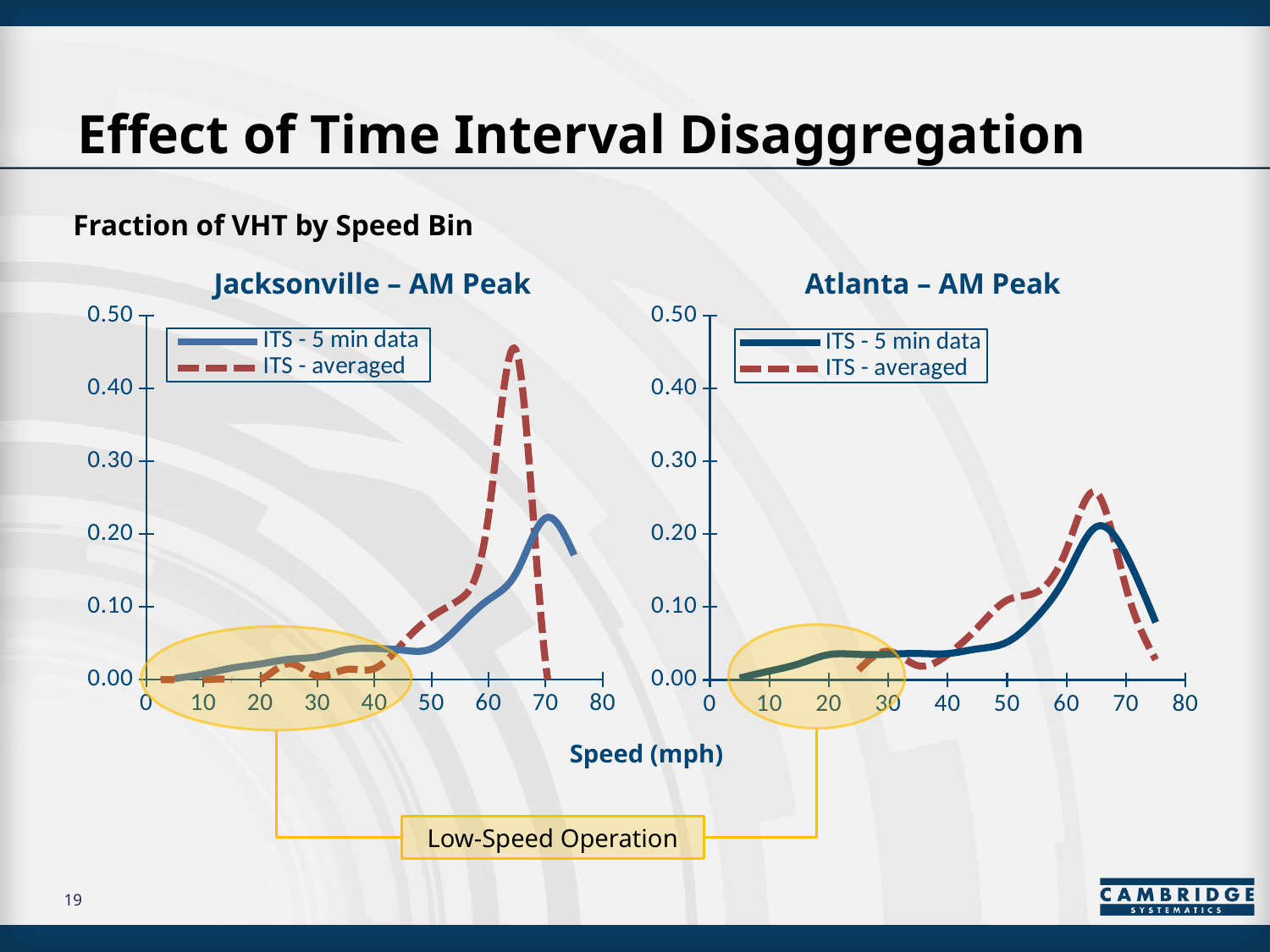
How many series does the legend of the Atlanta – AM Peak chart list? 2 In the Jacksonville – AM Peak chart, which series reaches the higher peak value, ITS - 5 min data or ITS - averaged? ITS - averaged In the Atlanta – AM Peak chart, does the ITS - 5 min data series rise or fall between 50 mph and 65 mph? rise In the Jacksonville – AM Peak chart, is the peak value of the ITS - averaged series greater or less than 0.40? greater What is the label of the shared x axis below the two charts? Speed (mph) In the Atlanta – AM Peak chart, is the peak value of the ITS - averaged series greater or less than 0.20? greater In the Atlanta – AM Peak chart, is the peak value of the ITS - 5 min data series greater or less than 0.30? less What kind of chart is the Jacksonville – AM Peak chart? line chart What is the highest tick value shown on the y axis of the Jacksonville – AM Peak chart? 0.50 In the Atlanta – AM Peak chart, which series reaches the higher peak value, ITS - 5 min data or ITS - averaged? ITS - averaged